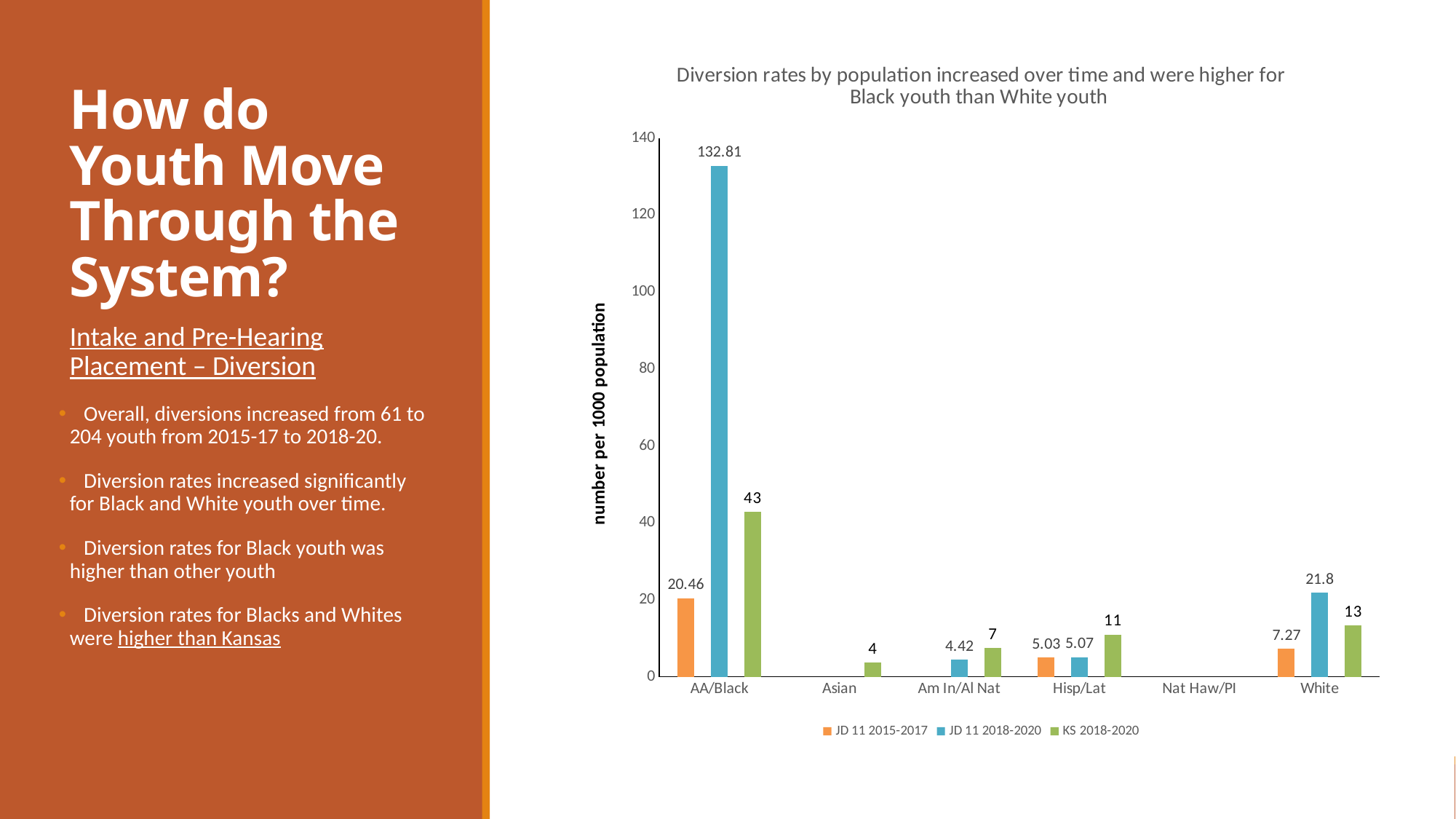
What is the KS 2018-2020 value for Hisp/Lat? 11 What is the JD 11 2018-2020 value for Am In/Al Nat? 4.42 Which category has the highest value in the KS 2018-2020 series? AA/Black What is the difference between the JD 11 2018-2020 and JD 11 2015-2017 values for AA/Black? 112.35 Is the JD 11 2018-2020 value for AA/Black greater or less than 120? greater How many categories are shown on the x axis? 6 Which category has the lowest value in the KS 2018-2020 series among those with a bar? Asian How many series does the legend list? 3 Which is larger for White: the JD 11 2018-2020 value or the KS 2018-2020 value? JD 11 2018-2020 What kind of chart is shown on the slide? bar chart What is the value for AA/Black in the JD 11 2018-2020 series? 132.81 What is the value for White in the JD 11 2015-2017 series? 7.27